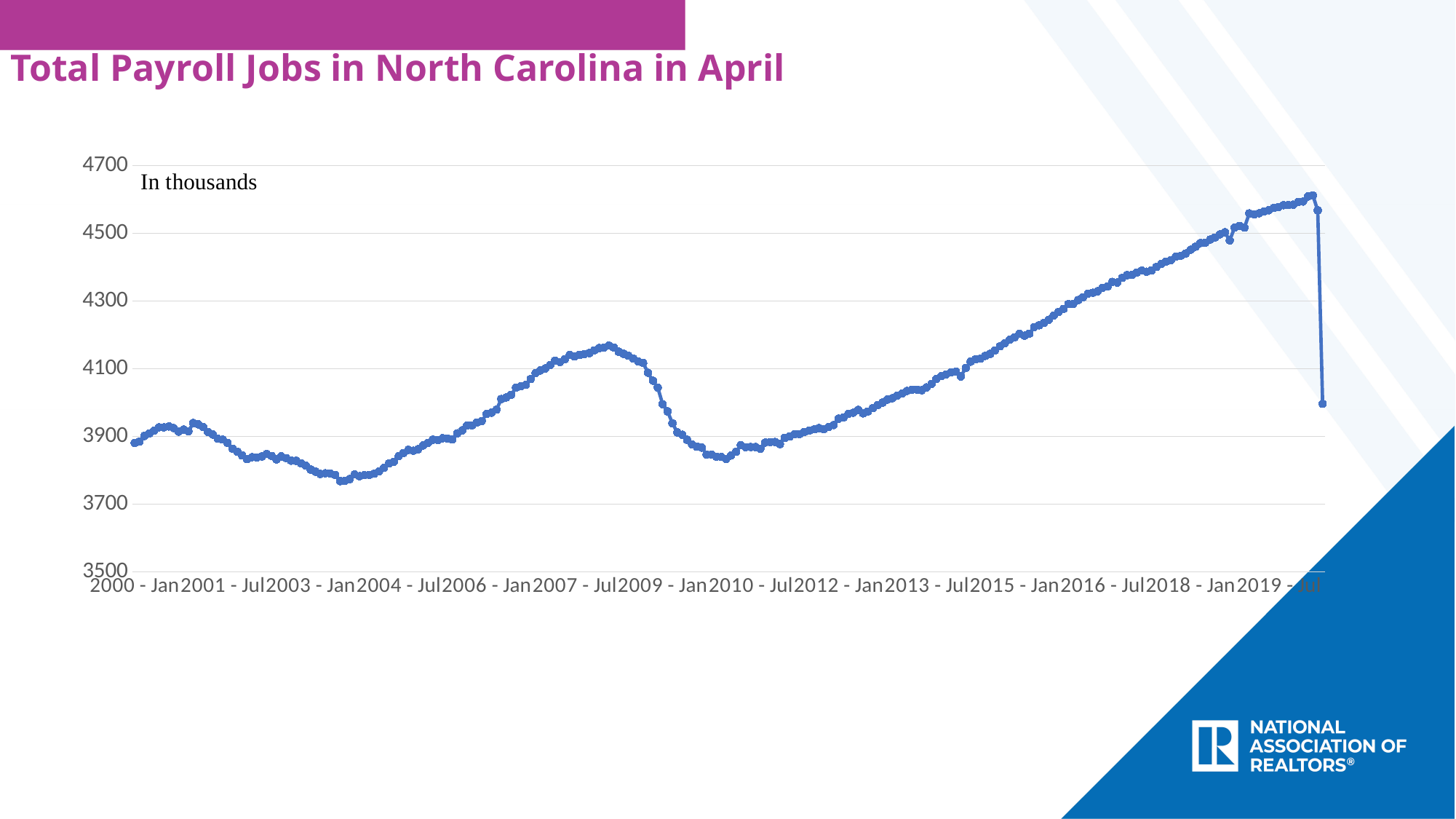
Is the value at 2007 - Jul greater or less than 3900? greater What is the title of the chart? Total Payroll Jobs in North Carolina in April Is the value at 2013 - Jul greater or less than 4300? less Is the value at 2003 - Jan greater or less than 3900? less Do the values generally rise or fall between 2010 - Jul and 2019 - Jul? rise Which is larger, the value at 2019 - Jul or the value at 2000 - Jan? 2019 - Jul What kind of chart is shown on the slide? line chart In what units are the values on the chart expressed, according to the note on the chart? In thousands Which is larger, the value at 2007 - Jul or the value at 2010 - Jul? 2007 - Jul